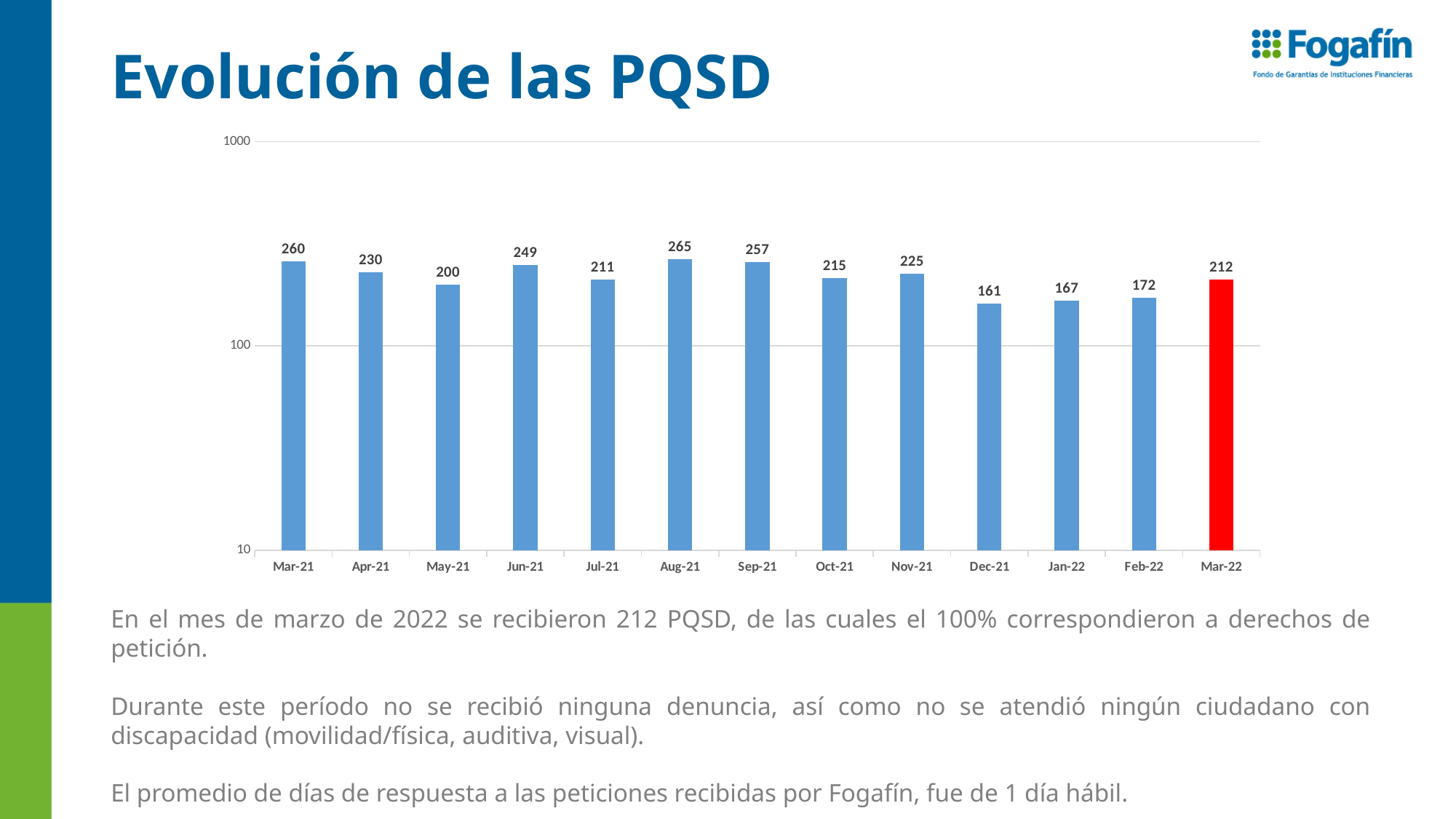
What is the value for Mar-22? 212 What is the difference between the values for Mar-21 and Mar-22? 48 Which bar is coloured red? Mar-22 Which month has the lowest value? Dec-21 What is the value for Aug-21? 265 Which month has the highest value? Aug-21 What is the value for Dec-21? 161 Do the values rise or fall from Dec-21 to Feb-22? rise Which is larger, the value for Jun-21 or the value for Sep-21? Sep-21 Is the value for Feb-22 greater or less than 100? greater How many months are shown on the x axis? 13 What kind of chart is shown on the slide? bar chart